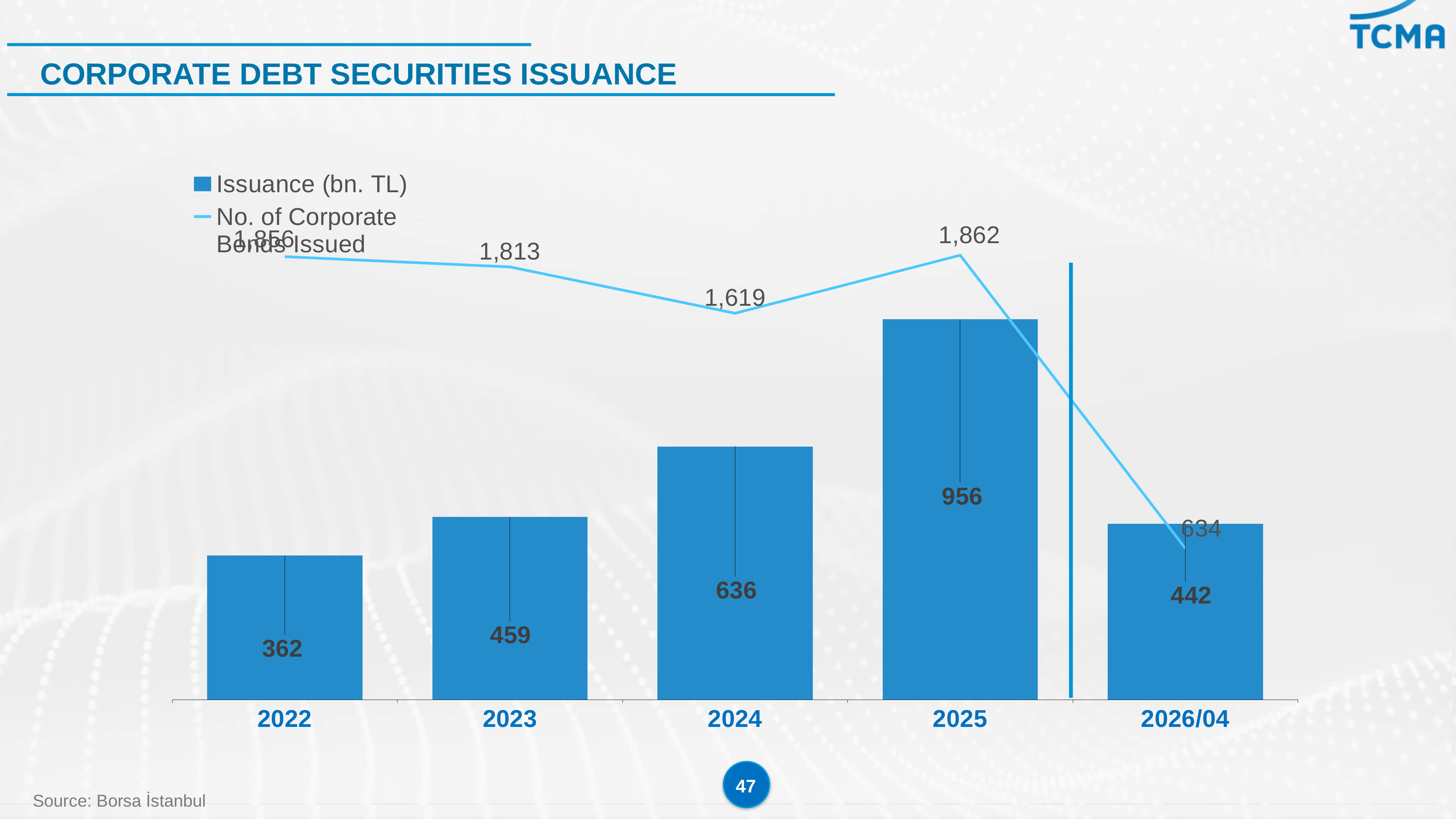
What is the No. of Corporate Bonds Issued in 2024? 1,619 Which year has the highest Issuance (bn. TL)? 2025 Does the Issuance (bn. TL) rise or fall from 2022 to 2025? rise Which period has the lowest No. of Corporate Bonds Issued? 2026/04 What is the Issuance (bn. TL) value for 2025? 956 What is the difference in Issuance (bn. TL) between 2025 and 2024? 320 How many periods are shown on the x axis? 5 What is the Issuance (bn. TL) value for 2022? 362 What is the No. of Corporate Bonds Issued in 2026/04? 634 Which is larger, the Issuance (bn. TL) for 2023 or for 2026/04? 2023 How many series does the legend list? 2 What is the title of the chart on the slide? CORPORATE DEBT SECURITIES ISSUANCE